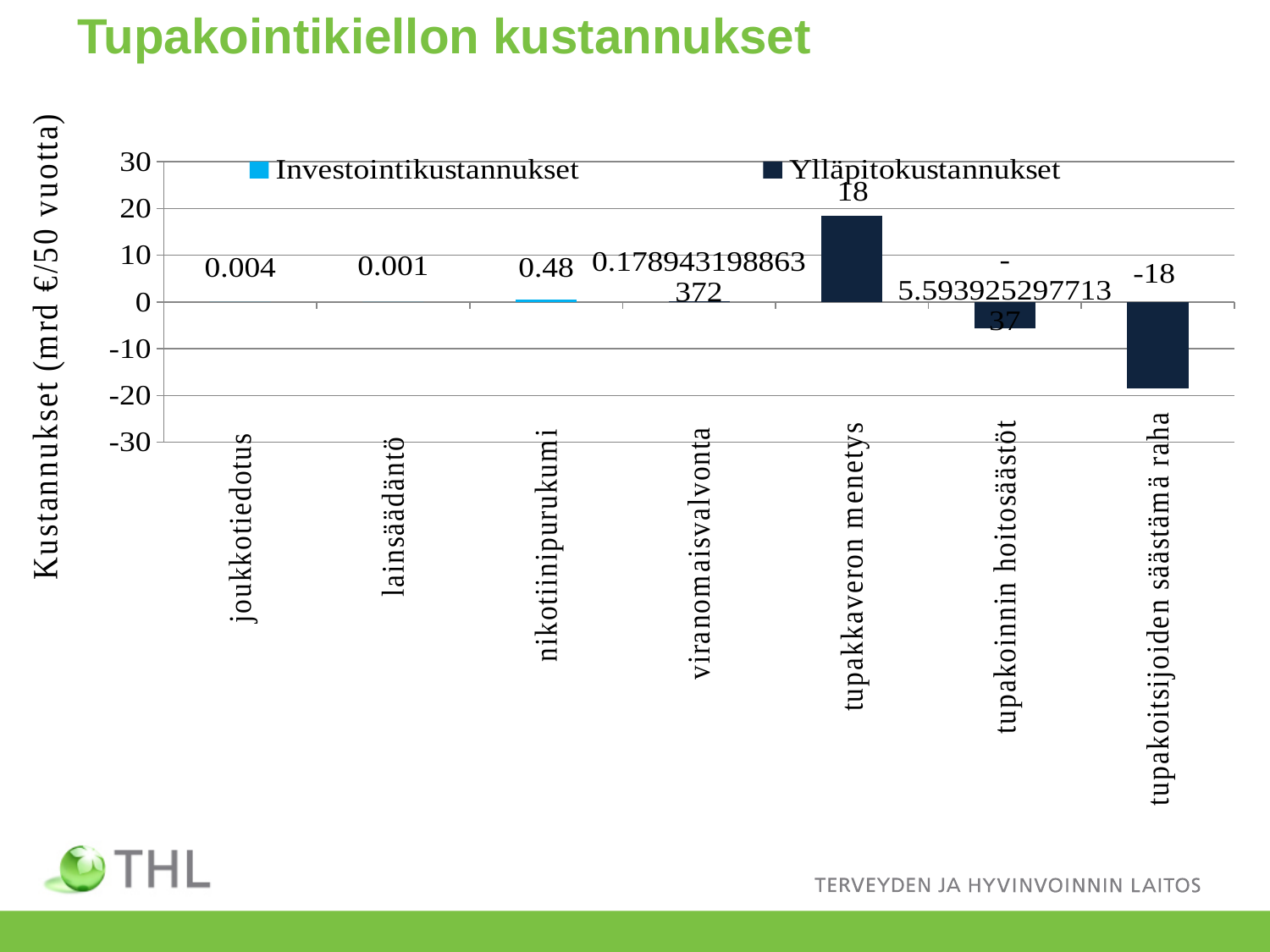
How many series does the legend list? 2 What kind of chart is shown on the slide? bar chart What is the value for tupakkaveron menetys? 18 What is the value for joukkotiedotus? 0.004 What is the value for tupakoitsijoiden säästämä raha? -18 Which category has the lowest value? tupakoitsijoiden säästämä raha Which is larger, the value for joukkotiedotus or the value for lainsäädäntö? joukkotiedotus Which category has the highest value? tupakkaveron menetys What is the difference between the values for tupakkaveron menetys and tupakoitsijoiden säästämä raha? 37 What is the value for nikotiinipurukumi? 0.48 How many categories are shown on the x axis? 7 What is the label of the vertical axis? Kustannukset (mrd €/50 vuotta)